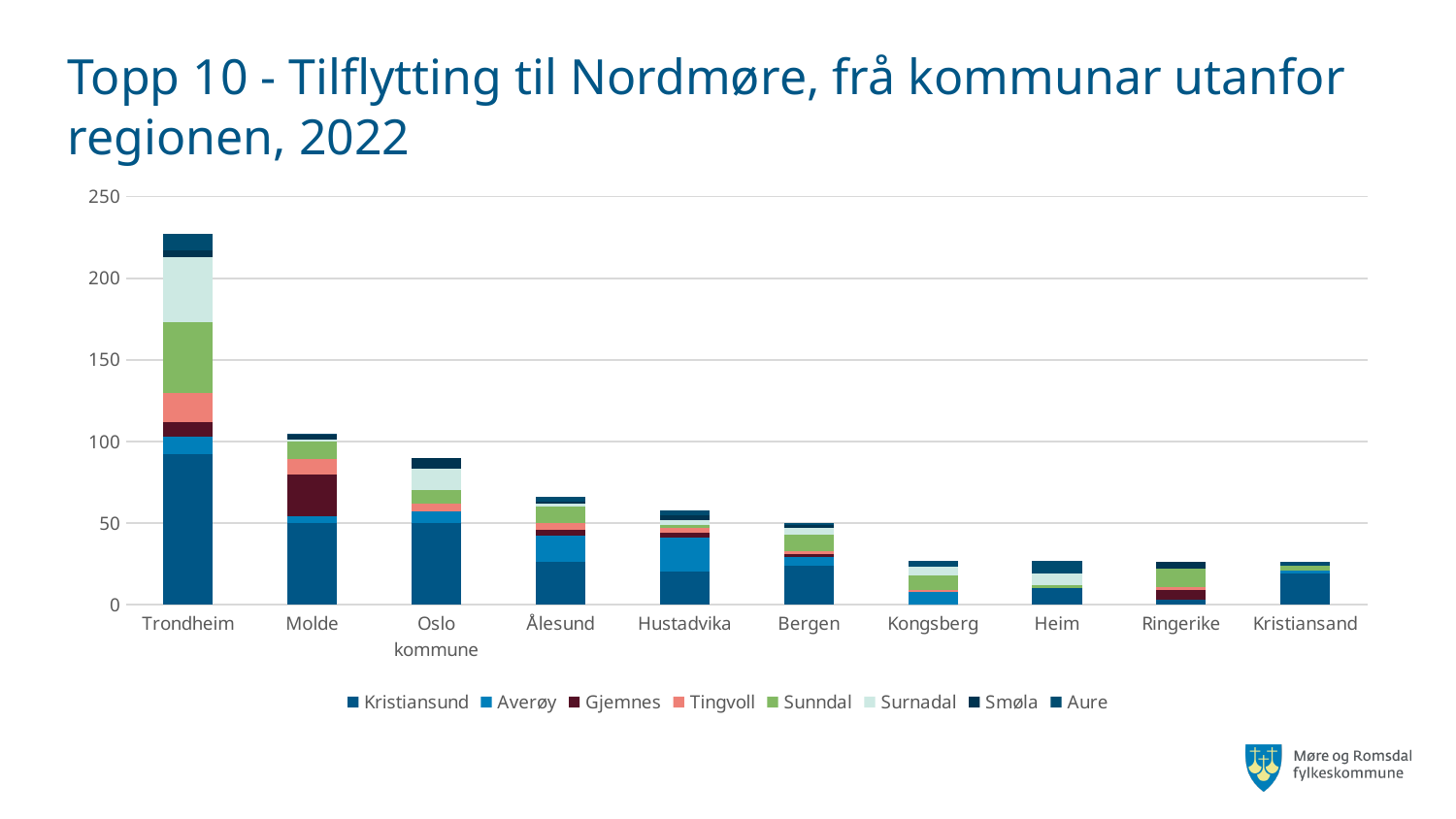
How many series does the legend list? 8 Do the total bar values rise or fall from left to right along the x axis? Fall Which has the larger total bar, Oslo kommune or Ålesund? Oslo kommune Which series is listed first in the legend? Kristiansund Which category has the highest total bar? Trondheim Is the total value for Trondheim greater or less than 200? greater How many categories (municipalities) are shown on the x axis? 10 Is the total value for Kongsberg greater or less than 50? less Which has the larger total bar, Trondheim or Molde? Trondheim Is the total value for Oslo kommune greater or less than 100? less What kind of chart is shown on the slide? Stacked bar chart